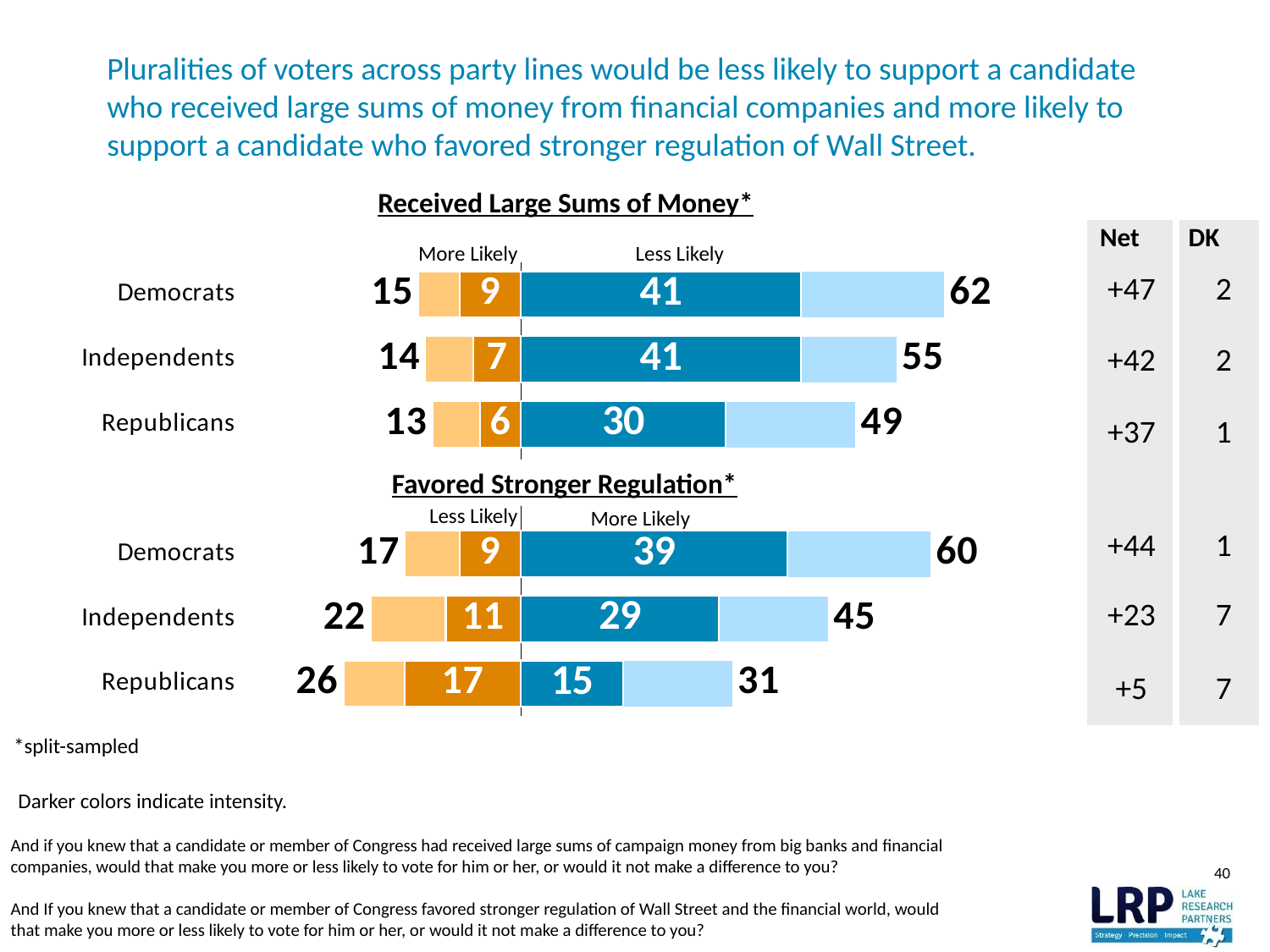
In the "Favored Stronger Regulation*" chart, which group has the larger Less Likely value, Independents or Republicans? Republicans In the "Received Large Sums of Money*" chart, which group has the highest Less Likely value? Democrats In the "Received Large Sums of Money*" chart, what is the More Likely value for Republicans? 13 In the "Favored Stronger Regulation*" chart, what is the Net value for Republicans? +5 In the "Received Large Sums of Money*" chart, what is the DK value for Independents? 2 In the "Received Large Sums of Money*" chart, what is the difference between the Less Likely and More Likely values for Democrats? 47 In the "Favored Stronger Regulation*" chart, what is the difference between the More Likely values for Democrats and Republicans? 29 In the "Favored Stronger Regulation*" chart, which group has the lowest More Likely value? Republicans In the "Favored Stronger Regulation*" chart, what is the dark-blue (intense) More Likely value for Independents? 29 How many voter groups are shown in the "Received Large Sums of Money*" chart? 3 In the "Received Large Sums of Money*" chart, what percentage of Democrats say they would be less likely to support the candidate? 62 What kind of chart is used to show the "Favored Stronger Regulation*" results? Bar chart